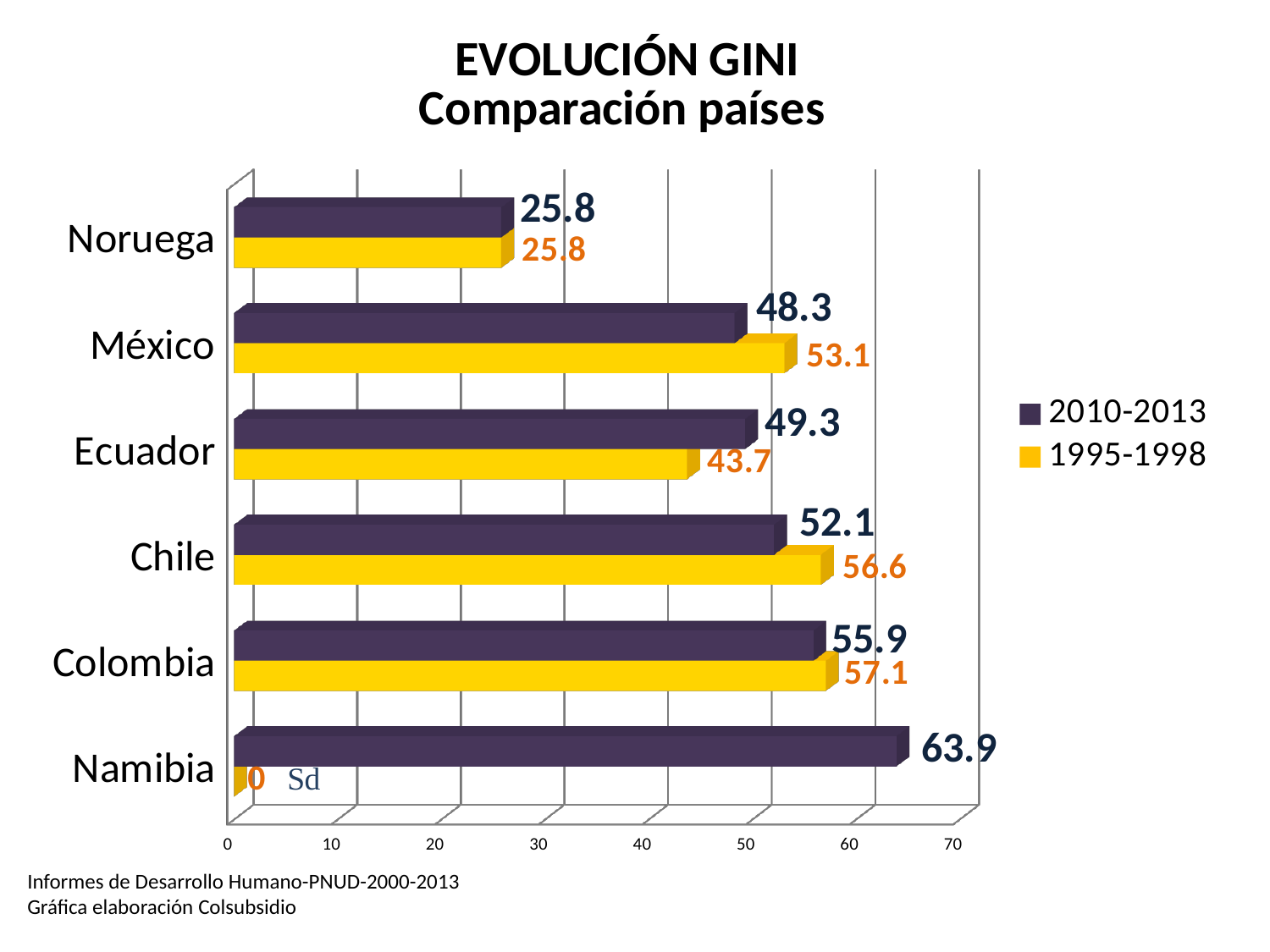
What is the title of the chart? EVOLUCIÓN GINI Comparación países Which country has the lowest Gini value in the 2010-2013 series? Noruega What kind of chart is shown on the slide? Bar chart What is the difference between the 1995-1998 and 2010-2013 Gini values for México? 4.8 Which country has the highest Gini value in the 2010-2013 series? Namibia How many series does the legend list? 2 Which is larger for Ecuador: the 2010-2013 value or the 1995-1998 value? 2010-2013 What is the Gini value for Namibia in the 2010-2013 series? 63.9 How many countries are shown on the chart? 6 What is the Gini value for Colombia in the 2010-2013 series? 55.9 What is the Gini value for Chile in the 1995-1998 series? 56.6 What is the Gini value for Ecuador in the 1995-1998 series? 43.7